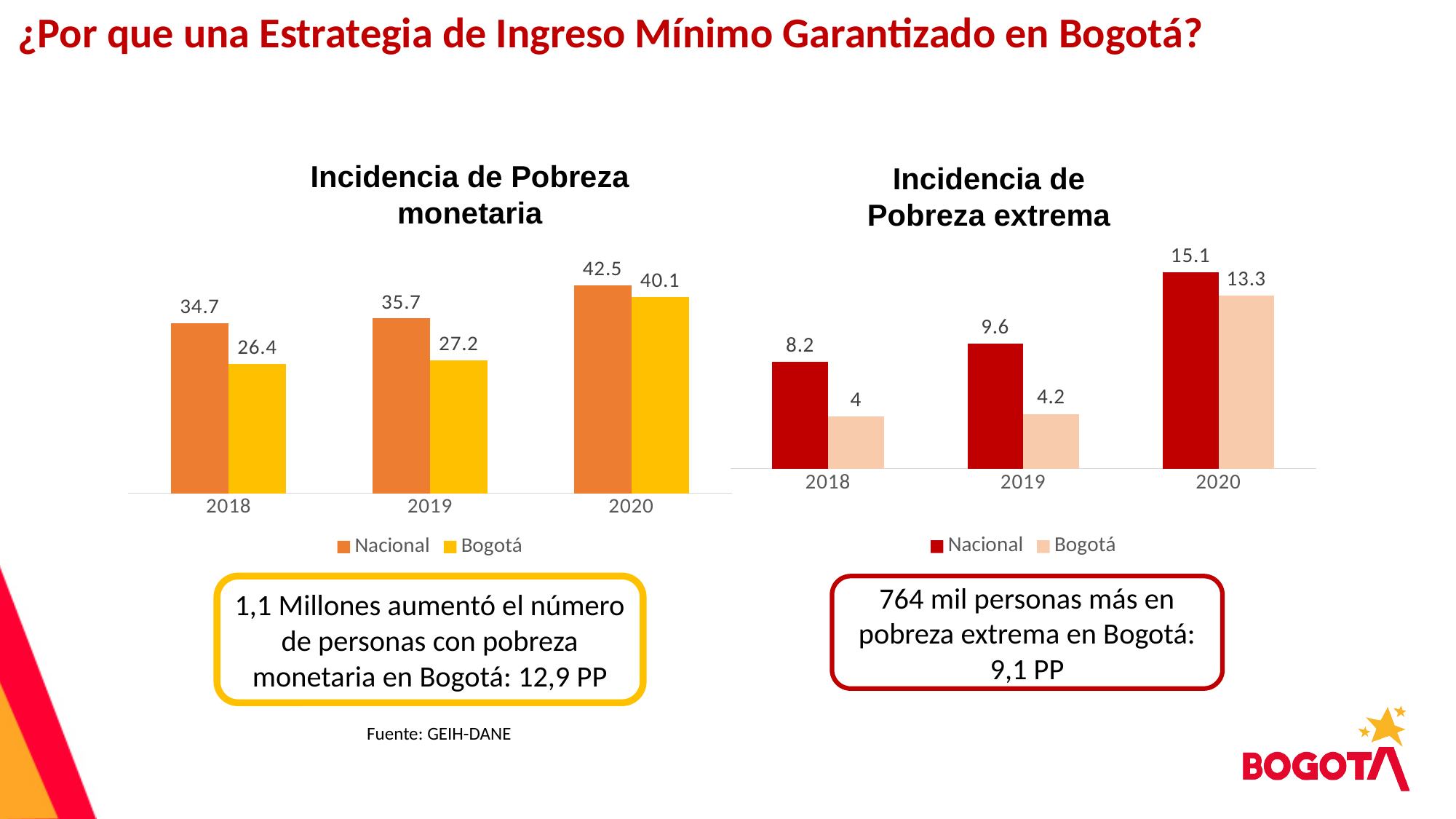
In the 'Incidencia de Pobreza extrema' chart, which is larger in 2020: Nacional or Bogotá? Nacional In the 'Incidencia de Pobreza extrema' chart, what is the value for Nacional in 2019? 9.6 How many series does the legend of the 'Incidencia de Pobreza extrema' chart list? 2 In the 'Incidencia de Pobreza extrema' chart, which year has the lowest Nacional value? 2018 In the 'Incidencia de Pobreza extrema' chart, what is the value for Bogotá in 2018? 4 How many years are shown on the x axis of the 'Incidencia de Pobreza monetaria' chart? 3 In the 'Incidencia de Pobreza monetaria' chart, what is the value for Bogotá in 2019? 27.2 In the 'Incidencia de Pobreza extrema' chart, what is the difference between the Bogotá values for 2020 and 2019? 9.1 In the 'Incidencia de Pobreza monetaria' chart, what is the difference between the Nacional and Bogotá values in 2018? 8.3 In the 'Incidencia de Pobreza monetaria' chart, which year has the highest Bogotá value? 2020 In the 'Incidencia de Pobreza monetaria' chart, do the Bogotá values rise or fall from 2018 to 2020? rise In the 'Incidencia de Pobreza monetaria' chart, what is the value for Nacional in 2020? 42.5